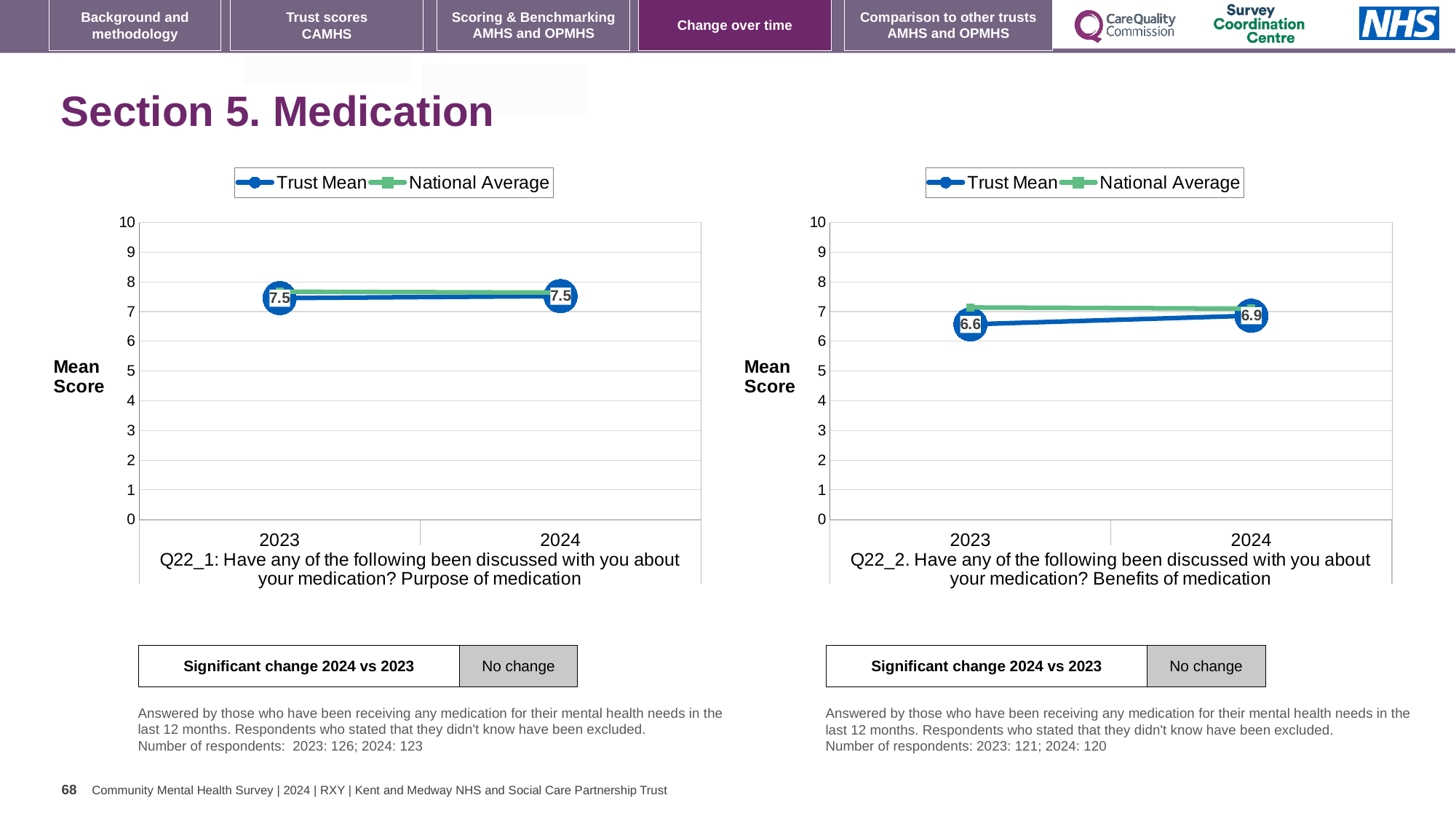
In the left chart (Q22_1: Purpose of medication), what is the Trust Mean score for 2024? 7.5 In the right chart (Q22_2: Benefits of medication), what is the Trust Mean score for 2024? 6.9 In the right chart (Q22_2: Benefits of medication), by how much did the Trust Mean change from 2023 to 2024? 0.3 In the left chart (Q22_1: Purpose of medication), what is the Trust Mean score for 2023? 7.5 What kind of chart is used for Q22_1: Purpose of medication? line chart How many years are shown on the x axis of the left chart (Q22_1: Purpose of medication)? 2 In the left chart (Q22_1: Purpose of medication), does the Trust Mean rise, fall or stay the same from 2023 to 2024? stay the same In the right chart (Q22_2: Benefits of medication), which is larger for 2023, the Trust Mean or the National Average? National Average How many series does the legend of the right chart (Q22_2: Benefits of medication) list? 2 In the right chart (Q22_2: Benefits of medication), what is the Trust Mean score for 2023? 6.6 In the right chart (Q22_2: Benefits of medication), does the Trust Mean rise or fall from 2023 to 2024? rise